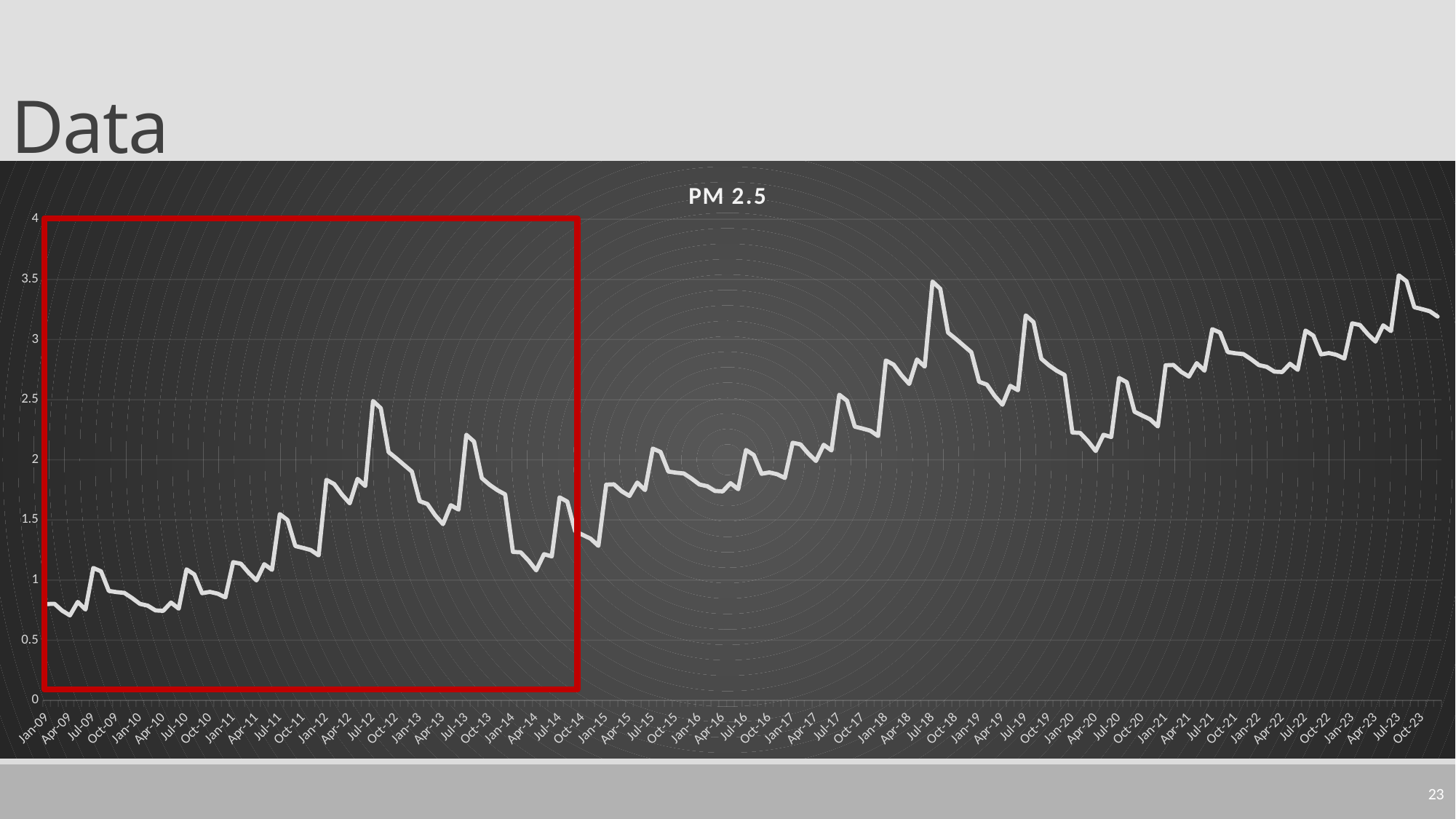
Is the value for Jul-19 greater or less than 3? greater Is the value for Jan-16 greater or less than 2? less Is the value for Jan-09 greater or less than 1? less Overall, do the PM 2.5 values rise or fall from Jan-09 to Oct-23? rise What is the title of the chart? PM 2.5 What kind of chart is shown on the slide? line chart Which is larger, the value for Jul-18 or the value for Jan-09? Jul-18 What is the first label on the x axis? Jan-09